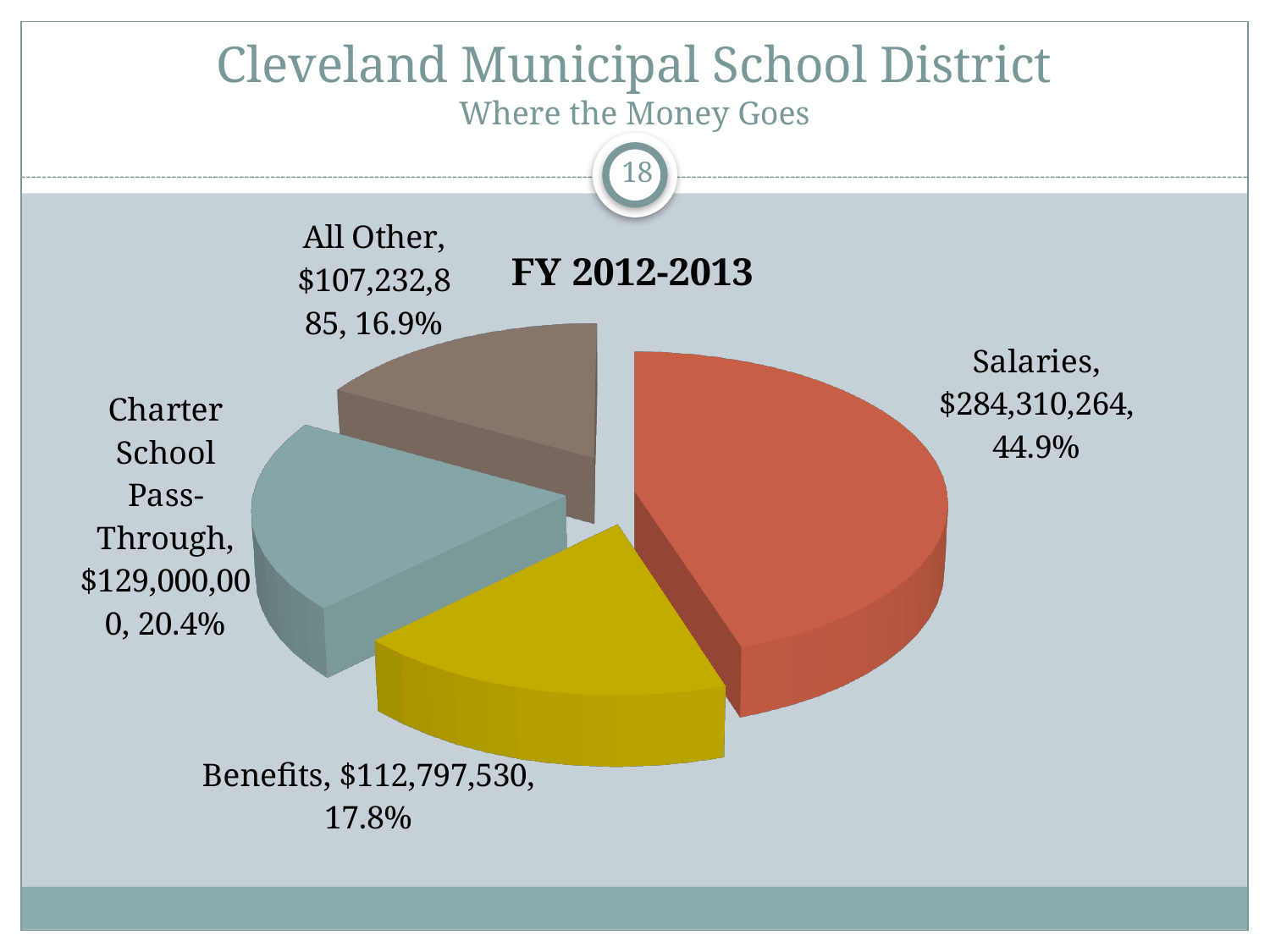
Which is larger, Charter School Pass-Through or Benefits? Charter School Pass-Through Which category has the largest slice of the pie? Salaries What is the dollar value for Charter School Pass-Through? $129,000,000 What percentage share does All Other have? 16.9% Which category has the smallest slice of the pie? All Other How many categories are shown in the pie chart? 4 What colour is the Salaries slice? Red What is the difference in dollars between Salaries and Benefits? $171,512,734 What percentage share does Benefits have? 17.8% What is the title of the chart? FY 2012-2013 What is the dollar value for Salaries? $284,310,264 What kind of chart is shown on the slide? Pie chart